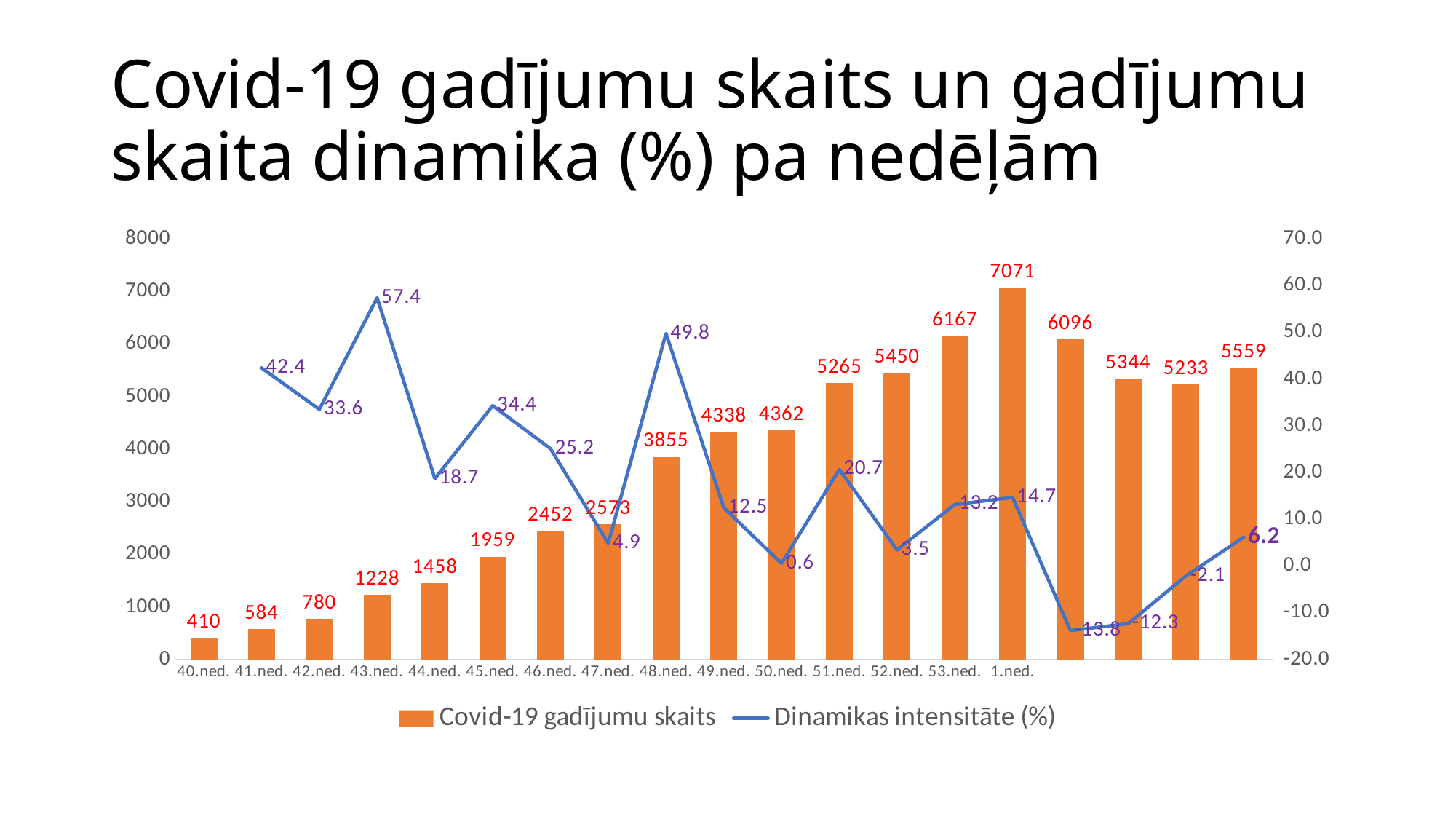
How many series does the legend list? 2 How many bars are plotted in the chart? 19 Which labelled week has the highest Covid-19 gadījumu skaits? 1.ned. What is the Dinamikas intensitāte (%) value for 43.ned.? 57.4 Which week has a larger Covid-19 gadījumu skaits, 49.ned. or 50.ned.? 50.ned. What is the Dinamikas intensitāte (%) value for 47.ned.? 4.9 Which week has the lowest Covid-19 gadījumu skaits? 40.ned. What kind of chart is shown on the slide? Combined bar and line chart What is the Covid-19 gadījumu skaits value for 45.ned.? 1959 Is the Covid-19 gadījumu skaits for 48.ned. greater or less than 4000? less Which week has the highest Dinamikas intensitāte (%) value? 43.ned. What is the difference in Covid-19 gadījumu skaits between 53.ned. and 52.ned.? 717